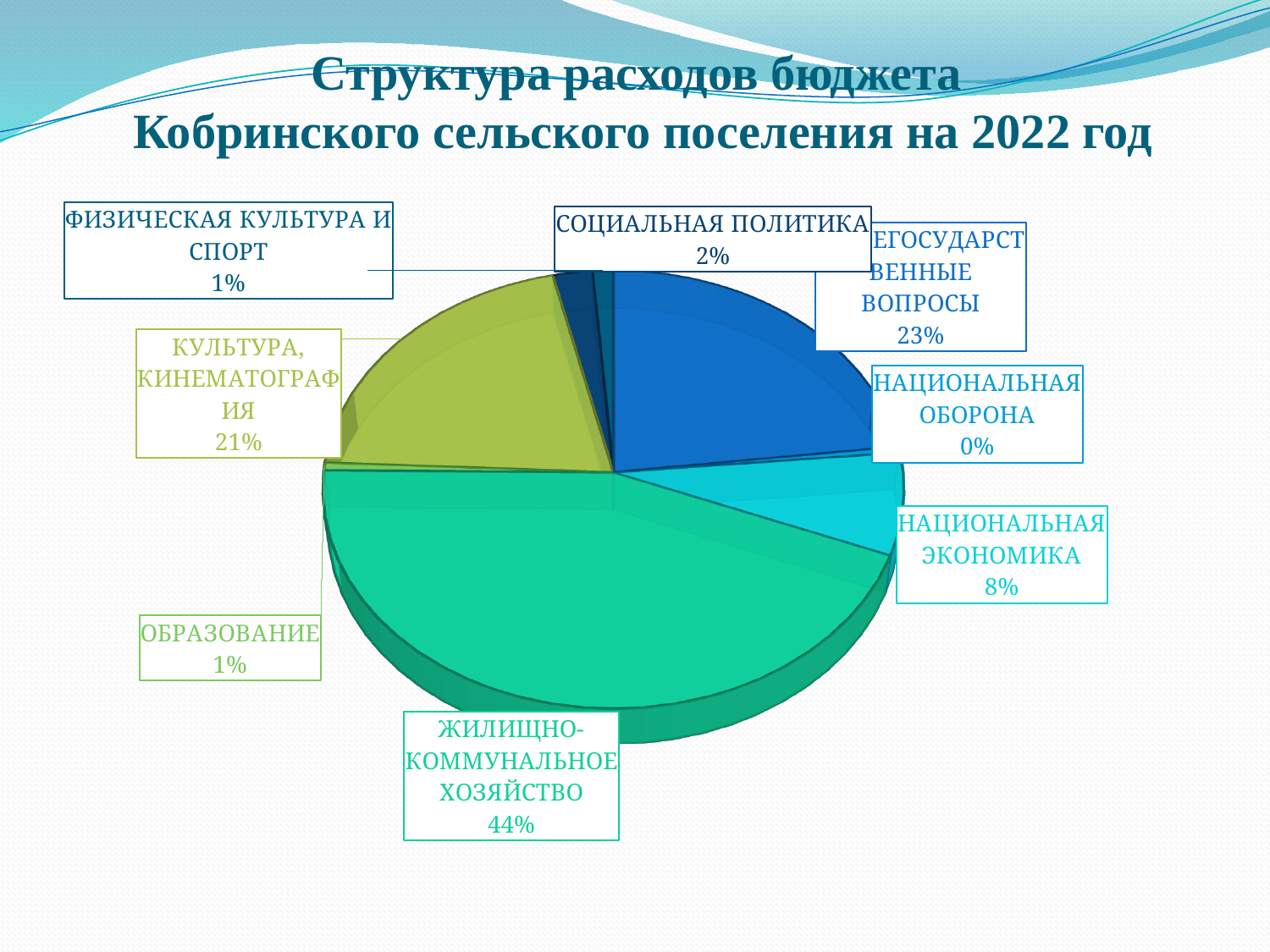
Which category has the largest share of the pie? ЖИЛИЩНО-КОММУНАЛЬНОЕ ХОЗЯЙСТВО What percentage is shown for the slice labelled ЕГОСУДАРСТВЕННЫЕ ВОПРОСЫ? 23% Which is larger: the share for НАЦИОНАЛЬНАЯ ЭКОНОМИКА or the share for СОЦИАЛЬНАЯ ПОЛИТИКА? НАЦИОНАЛЬНАЯ ЭКОНОМИКА What percentage is shown for НАЦИОНАЛЬНАЯ ЭКОНОМИКА? 8% What share of the pie does ЖИЛИЩНО-КОММУНАЛЬНОЕ ХОЗЯЙСТВО have? 44% What year does the chart title say the budget expenditure structure is for? 2022 What is the difference in percentage points between ЖИЛИЩНО-КОММУНАЛЬНОЕ ХОЗЯЙСТВО and КУЛЬТУРА, КИНЕМАТОГРАФИЯ? 23 How many categories are labelled on the pie chart? 8 What percentage is shown for КУЛЬТУРА, КИНЕМАТОГРАФИЯ? 21% What kind of chart is shown on the slide? Pie chart What percentage is shown for СОЦИАЛЬНАЯ ПОЛИТИКА? 2% Which category has the smallest share of the pie? НАЦИОНАЛЬНАЯ ОБОРОНА